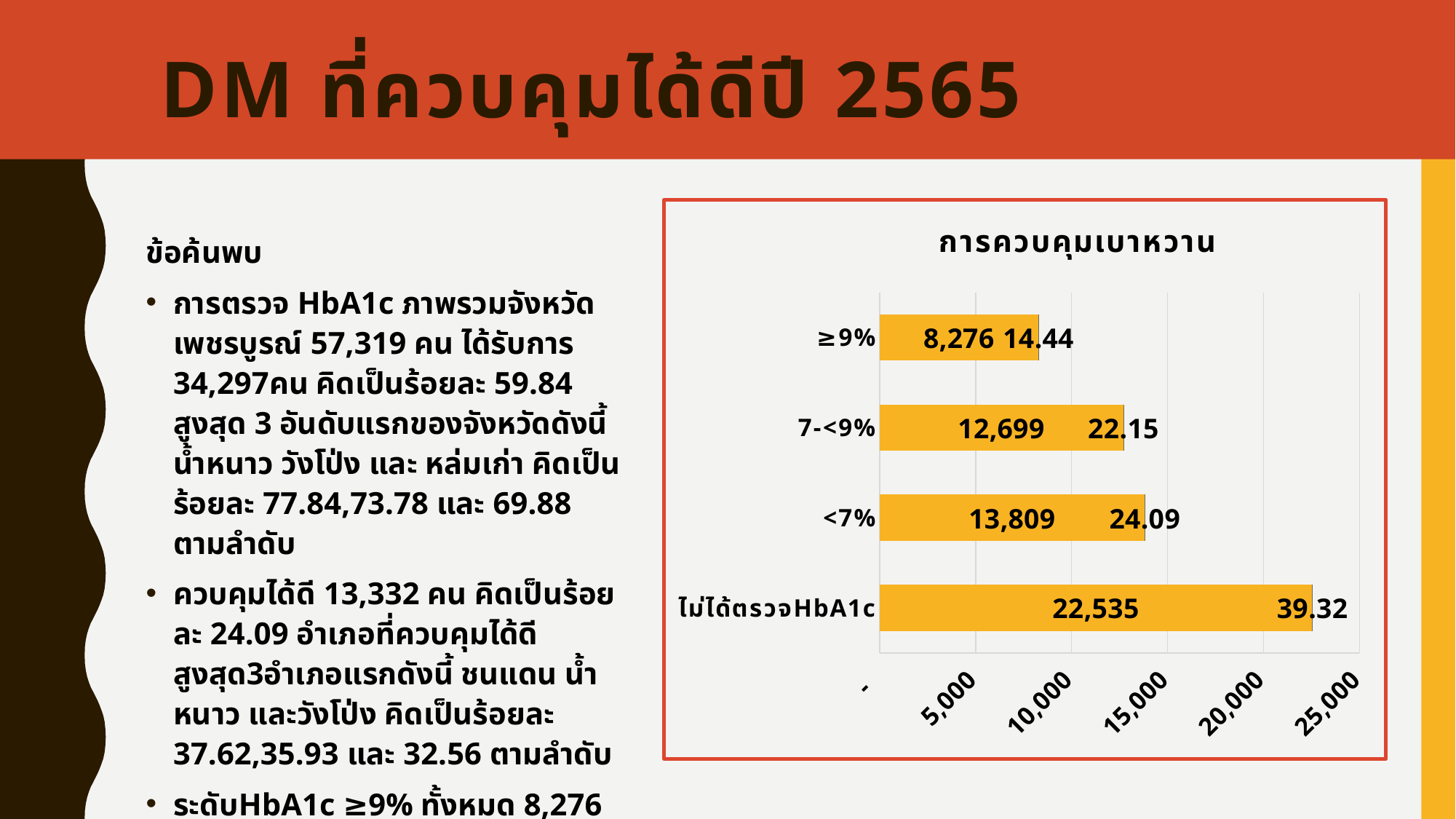
Which category has the lowest value? ≥9% What is the number of people in the ≥9% category? 8,276 Is the value for the 7-<9% category greater or less than 10,000? greater What is the number of people in the ไม่ได้ตรวจHbA1c category? 22,535 What type of chart is shown on the slide? bar chart What is the title of the chart? การควบคุมเบาหวาน What is the number of people in the <7% category? 13,809 Which category has the highest value? ไม่ได้ตรวจHbA1c What percentage is shown for the <7% category? 24.09 How many categories are shown in the chart? 4 What is the difference between the number of people in the <7% category and the 7-<9% category? 1,110 What is the number of people in the 7-<9% category? 12,699